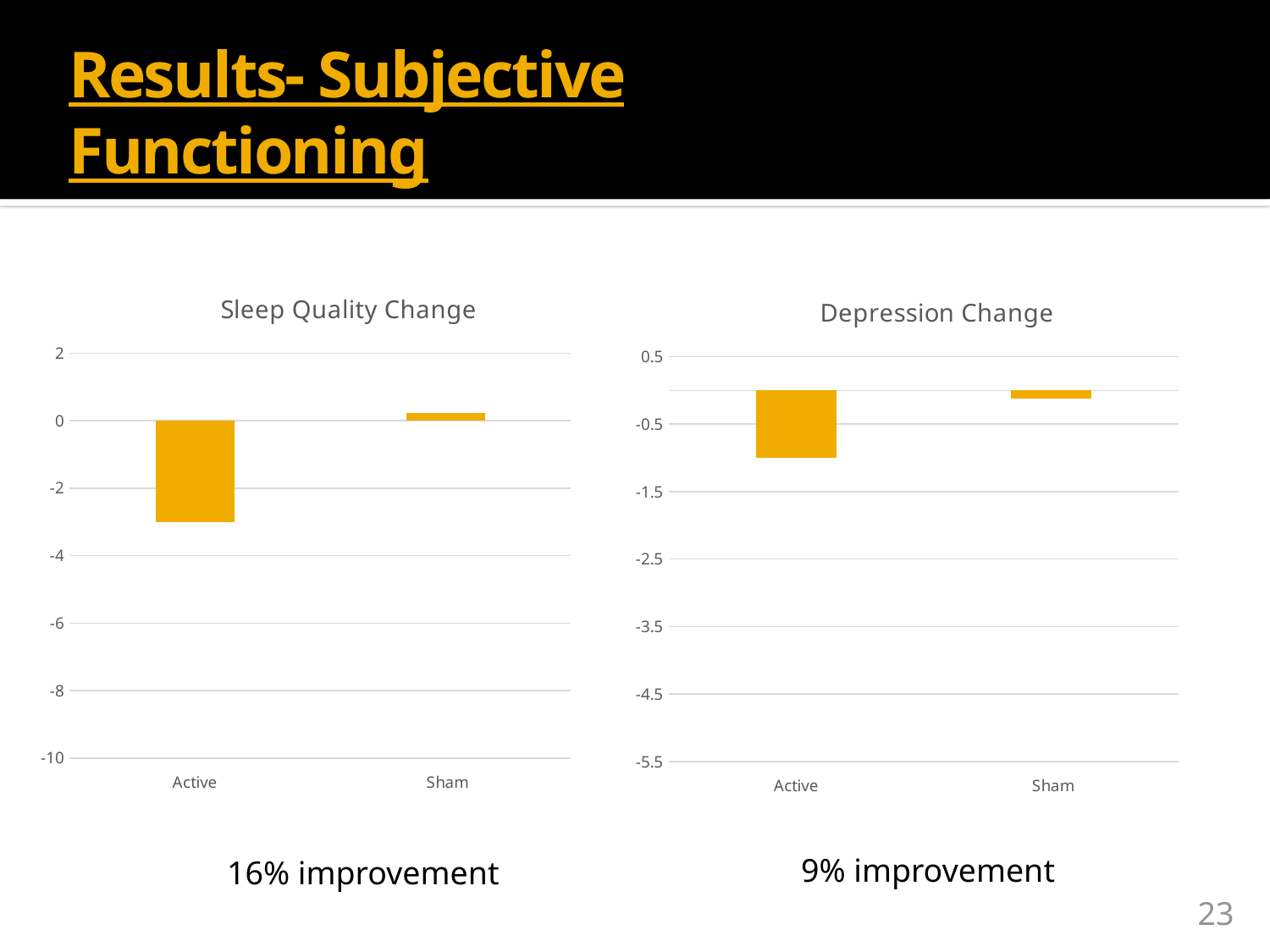
On the Sleep Quality Change chart, which is larger, the value for Active or the value for Sham? Sham On the Depression Change chart, which category has the highest value? Sham What is the title of the chart on the right side of the slide? Depression Change What kind of chart is the Depression Change chart? bar chart How many categories are shown on the Sleep Quality Change chart? 2 On the Sleep Quality Change chart, which category has the lowest value? Active What kind of chart is the Sleep Quality Change chart? bar chart On the Sleep Quality Change chart, is the value for Sham greater or less than 0? greater On the Sleep Quality Change chart, is the value for Active greater or less than -2? less How many categories are shown on the Depression Change chart? 2 On the Depression Change chart, is the value for Sham greater or less than -0.5? greater